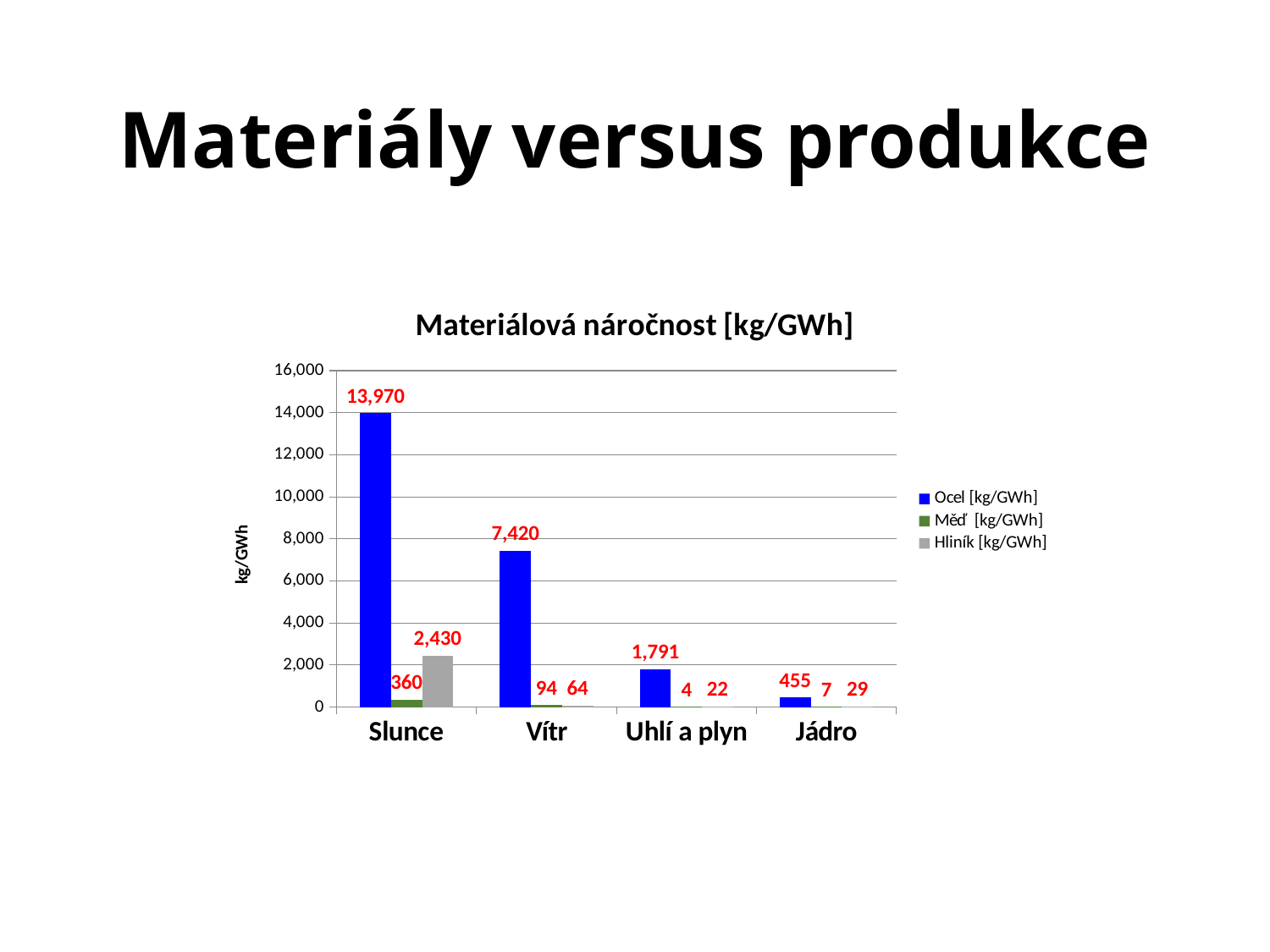
What is the value of Hliník [kg/GWh] for Slunce? 2,430 How many series does the legend list? 3 Which category has the highest Ocel [kg/GWh] value? Slunce What is the value of Měď [kg/GWh] for Vítr? 94 How many categories are shown on the x axis? 4 What is the value of Ocel [kg/GWh] for Jádro? 455 What is the difference between the Ocel [kg/GWh] values for Slunce and Vítr? 6,550 What kind of chart is shown on the slide? bar chart Which is larger: the Hliník [kg/GWh] value for Vítr or for Jádro? Vítr Which category has the lowest Měď [kg/GWh] value? Uhlí a plyn What is the value of Ocel [kg/GWh] for Slunce? 13,970 Is the Ocel [kg/GWh] value for Uhlí a plyn greater or less than 2,000? less